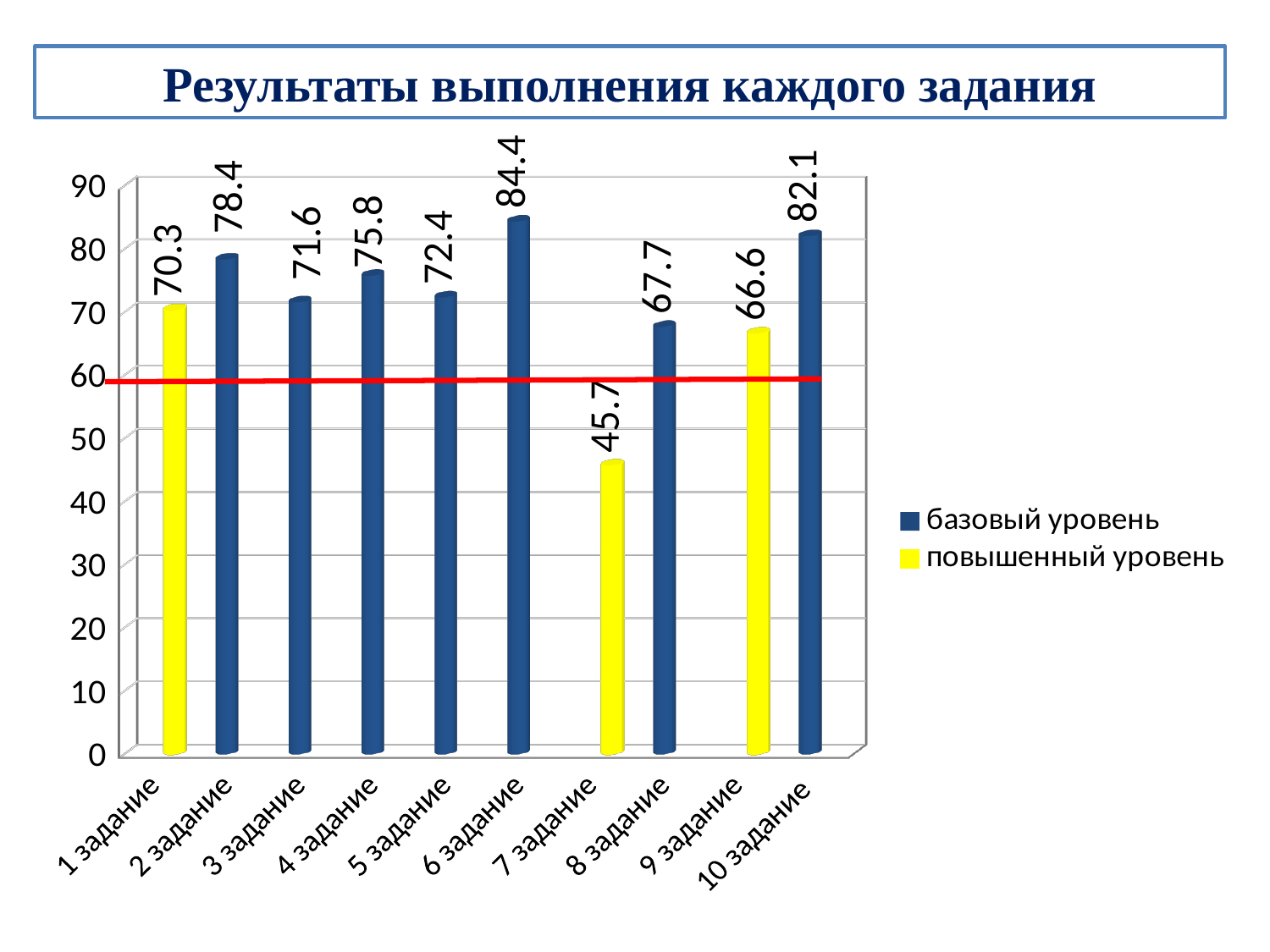
What is the value for 6 задание? 84.4 Which legend entry is shown in yellow? повышенный уровень What is the difference between the values for 10 задание and 9 задание? 15.5 Which task has the lowest value? 7 задание How many tasks are shown on the x axis? 10 What is the value for 7 задание? 45.7 Is the value for 8 задание greater or less than 60? greater Which is larger, the value for 2 задание or the value for 4 задание? 2 задание Which task has the highest value? 6 задание What is the value for 1 задание? 70.3 How many series does the legend list? 2 What kind of chart is shown on the slide? bar chart